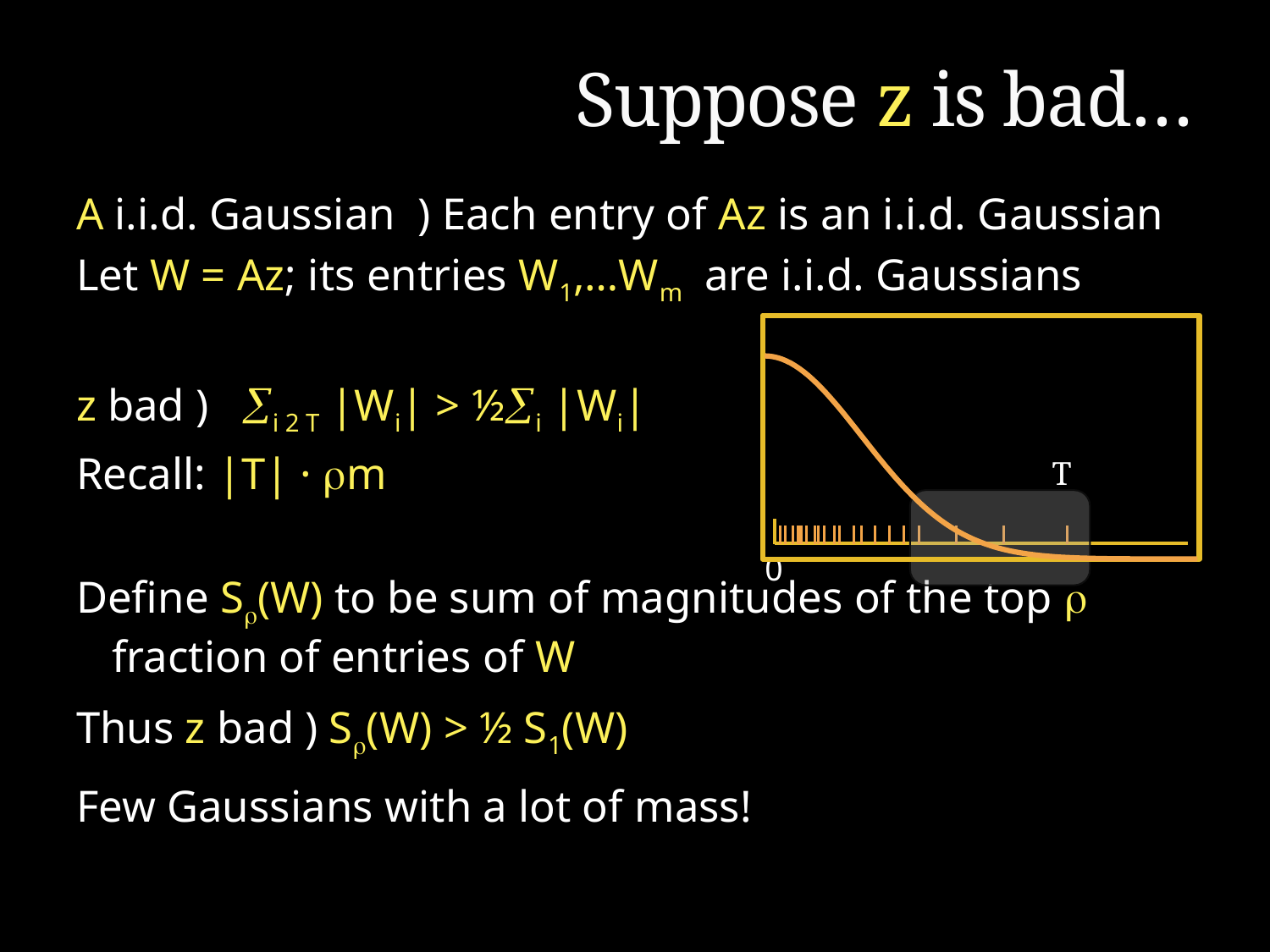
Are the tick marks on the chart's x axis denser near 0 or near the region labelled T? near 0 What label is printed at the left end of the x axis in the chart? 0 What letter labels the highlighted region on the right side of the chart's x axis? T Does the curve in the chart rise or fall as you move from left to right along the x axis? fall What kind of chart is shown in the box on the right of the slide? line chart